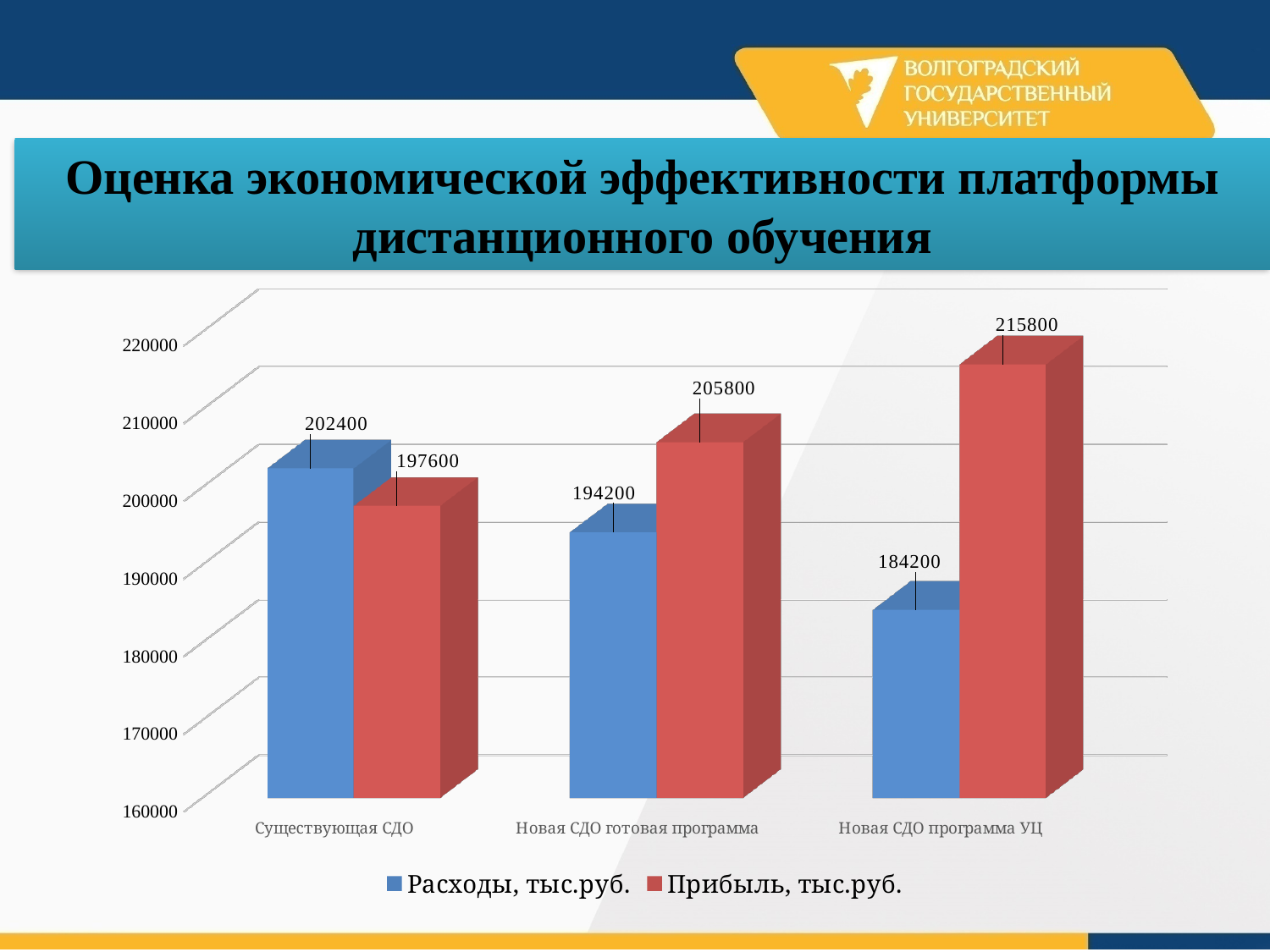
For Существующая СДО, which is larger: Расходы, тыс.руб. or Прибыль, тыс.руб.? Расходы, тыс.руб. How many series does the legend list? 2 What is the value of Прибыль, тыс.руб. for Новая СДО программа УЦ? 215800 Which category has the lowest Расходы, тыс.руб.? Новая СДО программа УЦ What is the difference between Прибыль, тыс.руб. and Расходы, тыс.руб. for Новая СДО программа УЦ? 31600 What is the value of Расходы, тыс.руб. for Существующая СДО? 202400 What kind of chart is shown on the slide? Bar chart Which category has the highest Прибыль, тыс.руб.? Новая СДО программа УЦ What is the difference between Расходы, тыс.руб. for Существующая СДО and for Новая СДО готовая программа? 8200 What is the value of Расходы, тыс.руб. for Новая СДО программа УЦ? 184200 What is the value of Прибыль, тыс.руб. for Новая СДО готовая программа? 205800 How many categories are shown on the x axis? 3